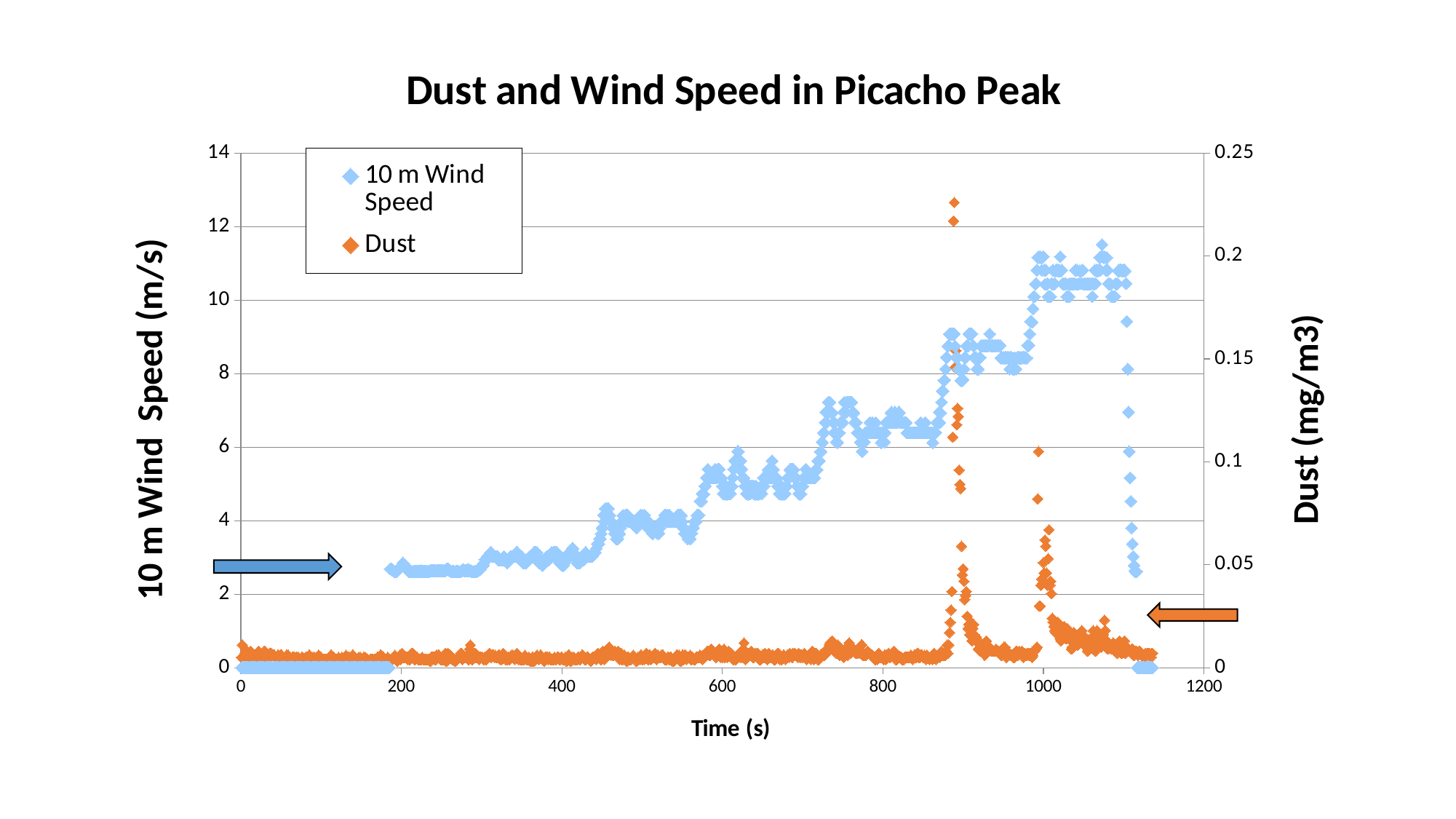
What is the label of the right-hand vertical axis? Dust (mg/m3) Which is larger, the 10 m Wind Speed at 1000 s or at 200 s? 1000 s Is the 10 m Wind Speed value at 400 s greater or less than 4? less Is the highest Dust value on the chart greater or less than 0.2? greater Is the 10 m Wind Speed value at 600 s greater or less than 4? greater How many series does the legend list? 2 What kind of chart is shown on the slide? scatter chart What is the title of the chart? Dust and Wind Speed in Picacho Peak Does the 10 m Wind Speed series generally rise or fall as time increases from 200 s to 1100 s? rise